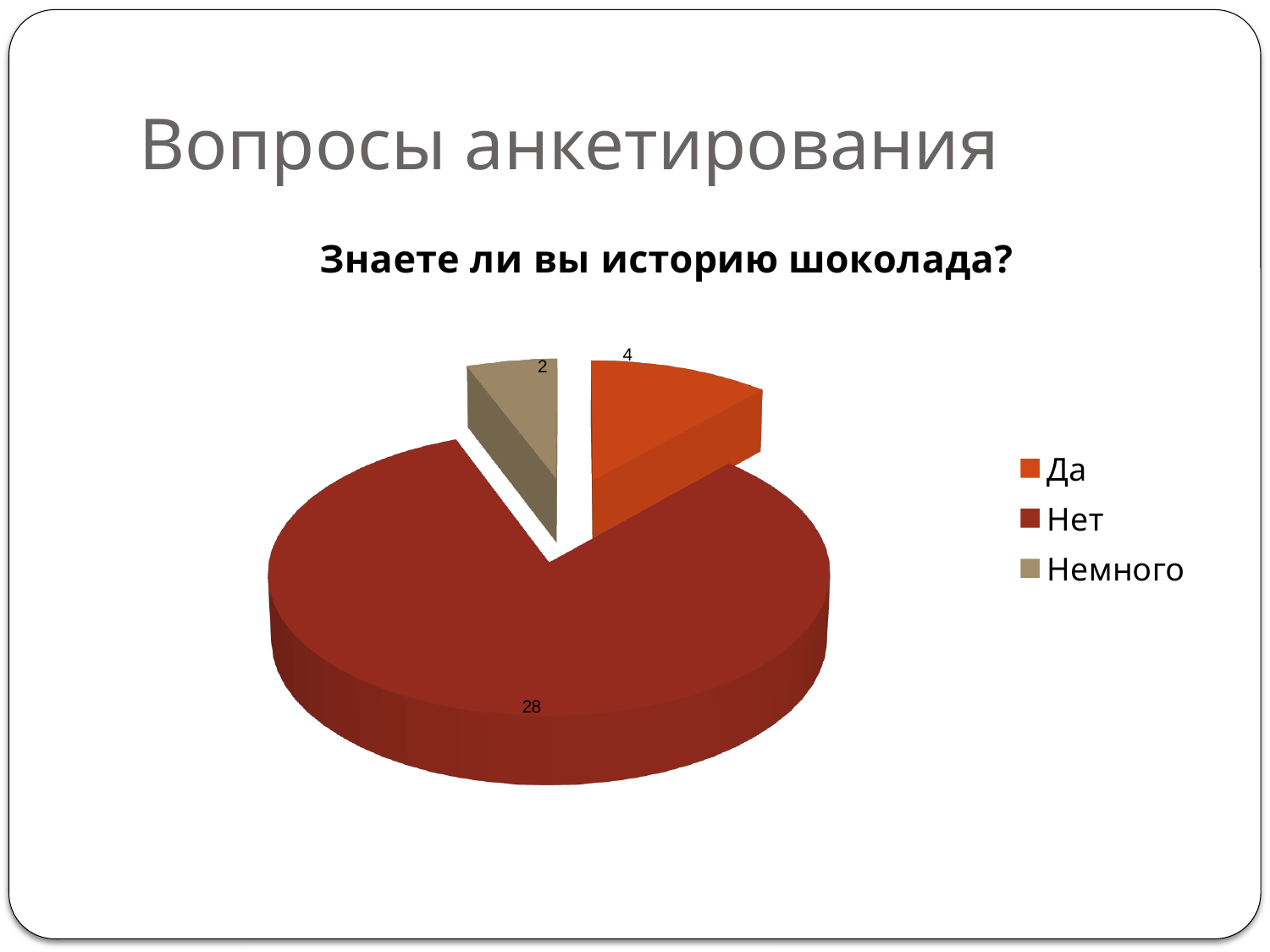
Which category has the largest slice? Нет What is the total of all slices in the pie chart? 34 What is the value for "Немного"? 2 How many categories does the pie chart have? 3 What is the value for "Да"? 4 What is the difference between the values for "Нет" and "Да"? 24 Which category has the smallest slice? Немного What type of chart is shown on the slide? pie chart What is the title of the chart? Знаете ли вы историю шоколада? What is the value for "Нет"? 28 What colour is the slice for "Нет"? dark red Which is larger, the value for "Да" or the value for "Немного"? Да